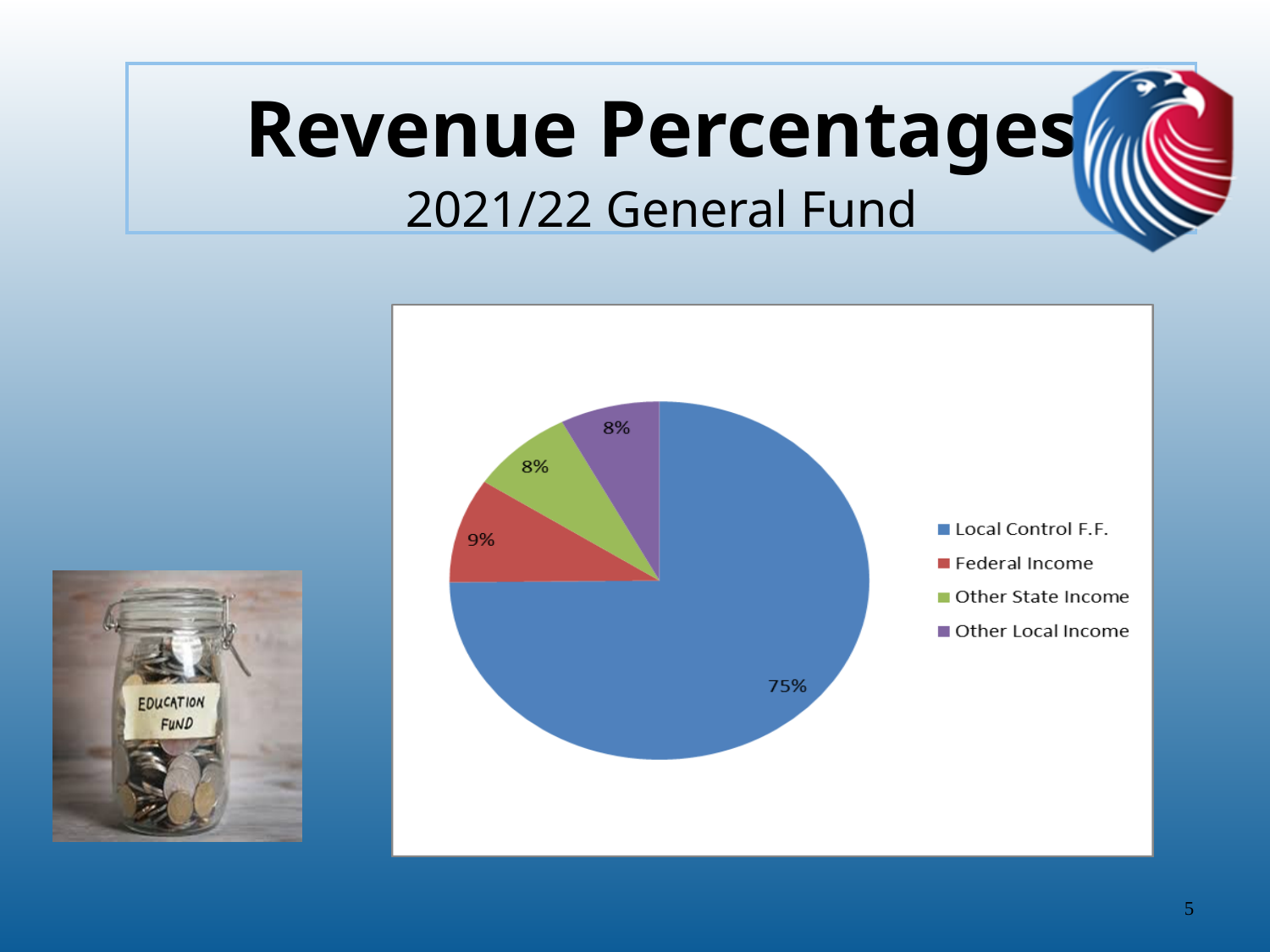
What percentage of the pie does Federal Income represent? 9% How many slices does the pie chart have? 4 What is the difference in percentage points between Federal Income and Other Local Income? 1 What percentage of the pie does Other Local Income represent? 8% Which category has the largest share of the pie? Local Control F.F. What percentage of the pie does Other State Income represent? 8% What kind of chart is shown on the slide? Pie chart How many entries does the legend list? 4 What is the difference in percentage points between Local Control F.F. and Federal Income? 66 What colour is the slice for Federal Income? Red Which is larger, the share for Federal Income or the share for Other State Income? Federal Income